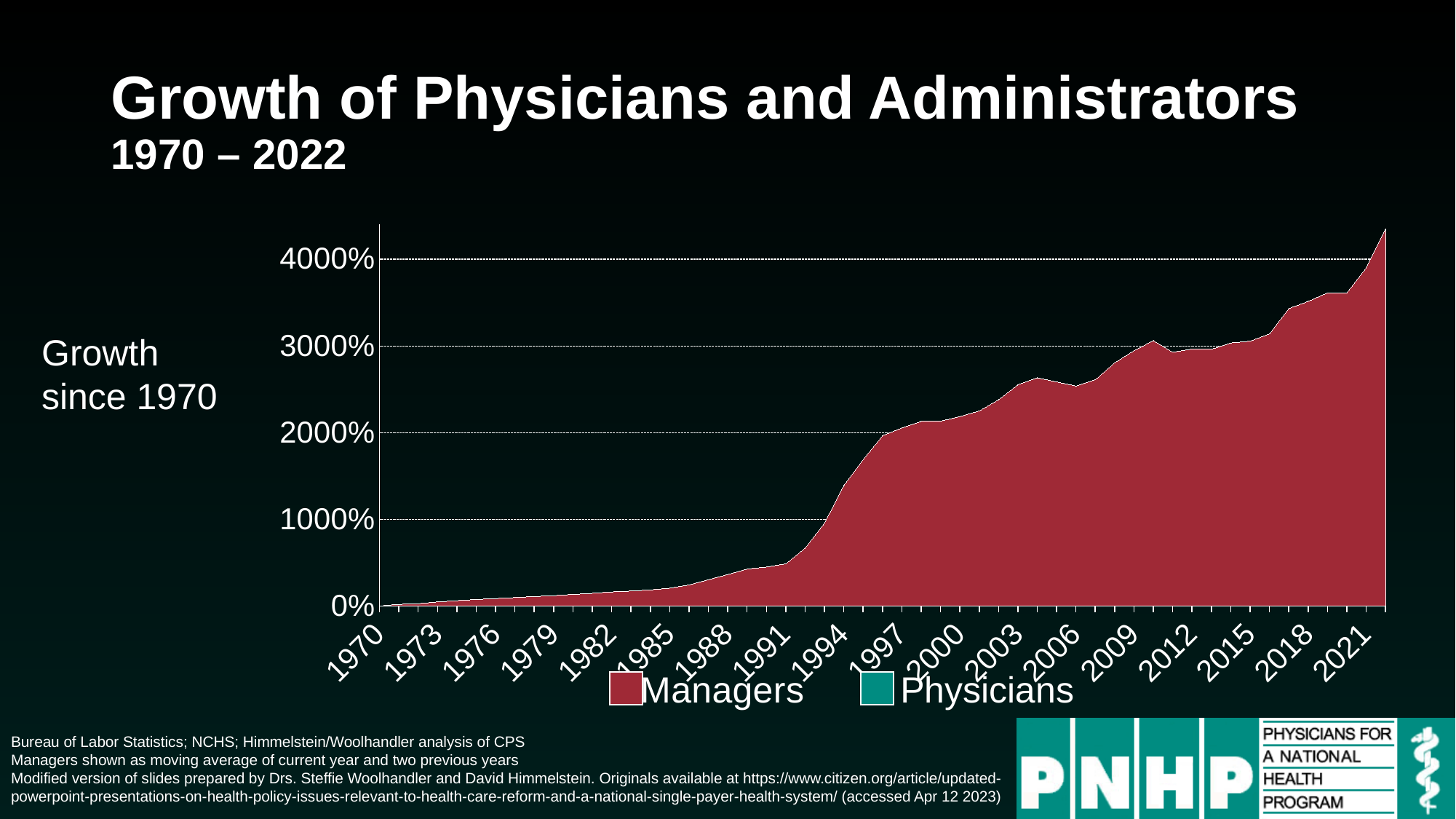
What is the title of the chart on the slide? Growth of Physicians and Administrators 1970 – 2022 Does the Managers series generally rise or fall from 1970 to 2021? Rise What are the two series named in the legend? Managers and Physicians Is the value for Managers in 2021 greater or less than 3000%? greater How many series does the legend list? 2 Which series shows the larger growth since 1970, Managers or Physicians? Managers Is the value for Managers in 2012 greater or less than 4000%? less Is the value for Managers in 1997 greater or less than 1000%? greater What kind of chart is shown on the slide? Area chart How many year labels are shown on the x axis? 18